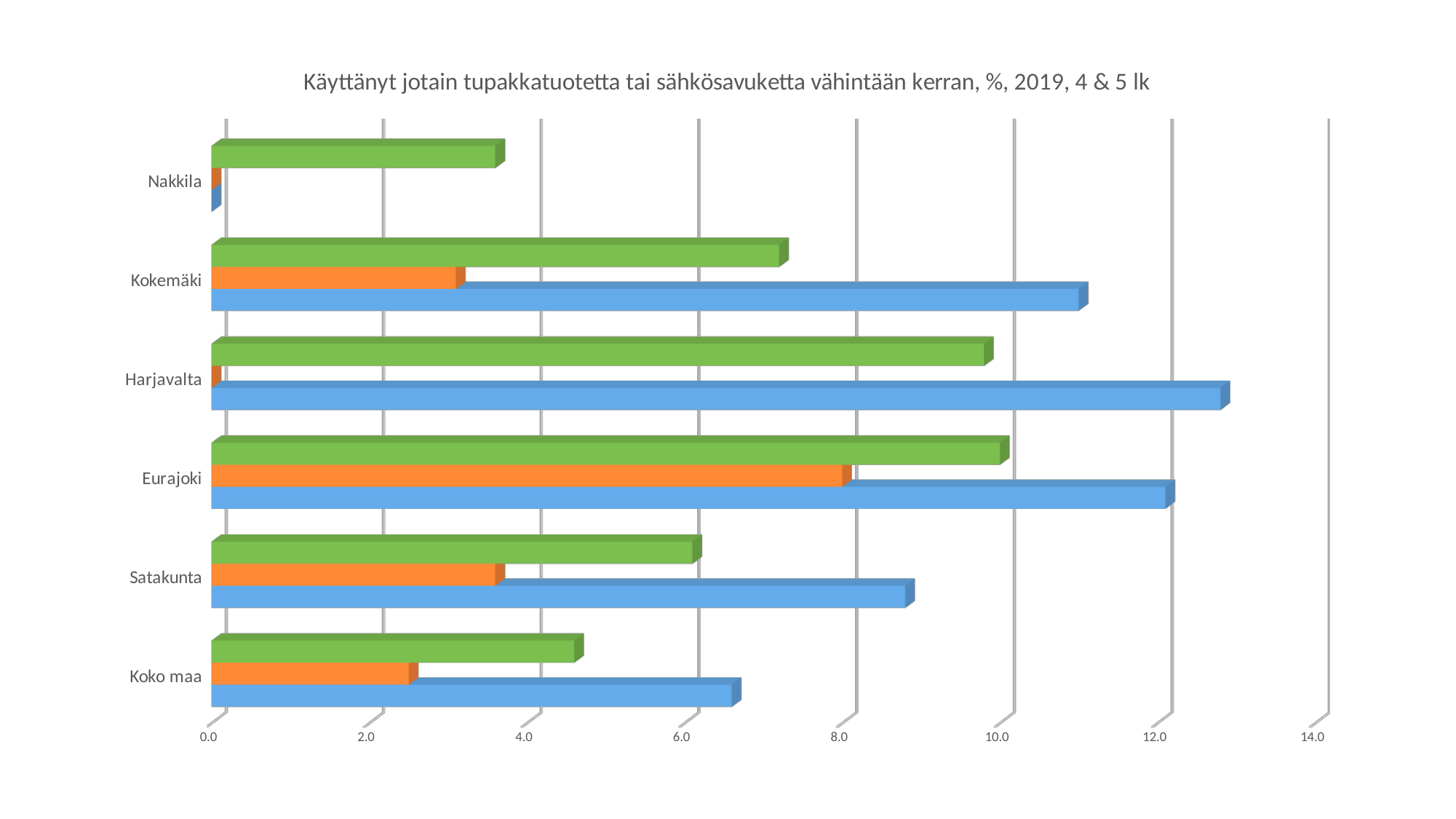
Is the green bar for Nakkila greater or less than 4.0? less What kind of chart is shown on the slide? bar chart Is the blue bar for Harjavalta greater or less than 12.0? greater Is the green bar for Kokemäki greater or less than 6.0? greater What is the highest value shown on the horizontal axis of the chart? 14.0 How many categories are shown on the vertical axis of the chart? 6 Which category has the longest orange bar? Eurajoki Which category has the longest blue bar? Harjavalta Which has the longer blue bar, Kokemäki or Satakunta? Kokemäki Which category has the shortest green bar? Nakkila What is the title of the chart? Käyttänyt jotain tupakkatuotetta tai sähkösavuketta vähintään kerran, %, 2019, 4 & 5 lk